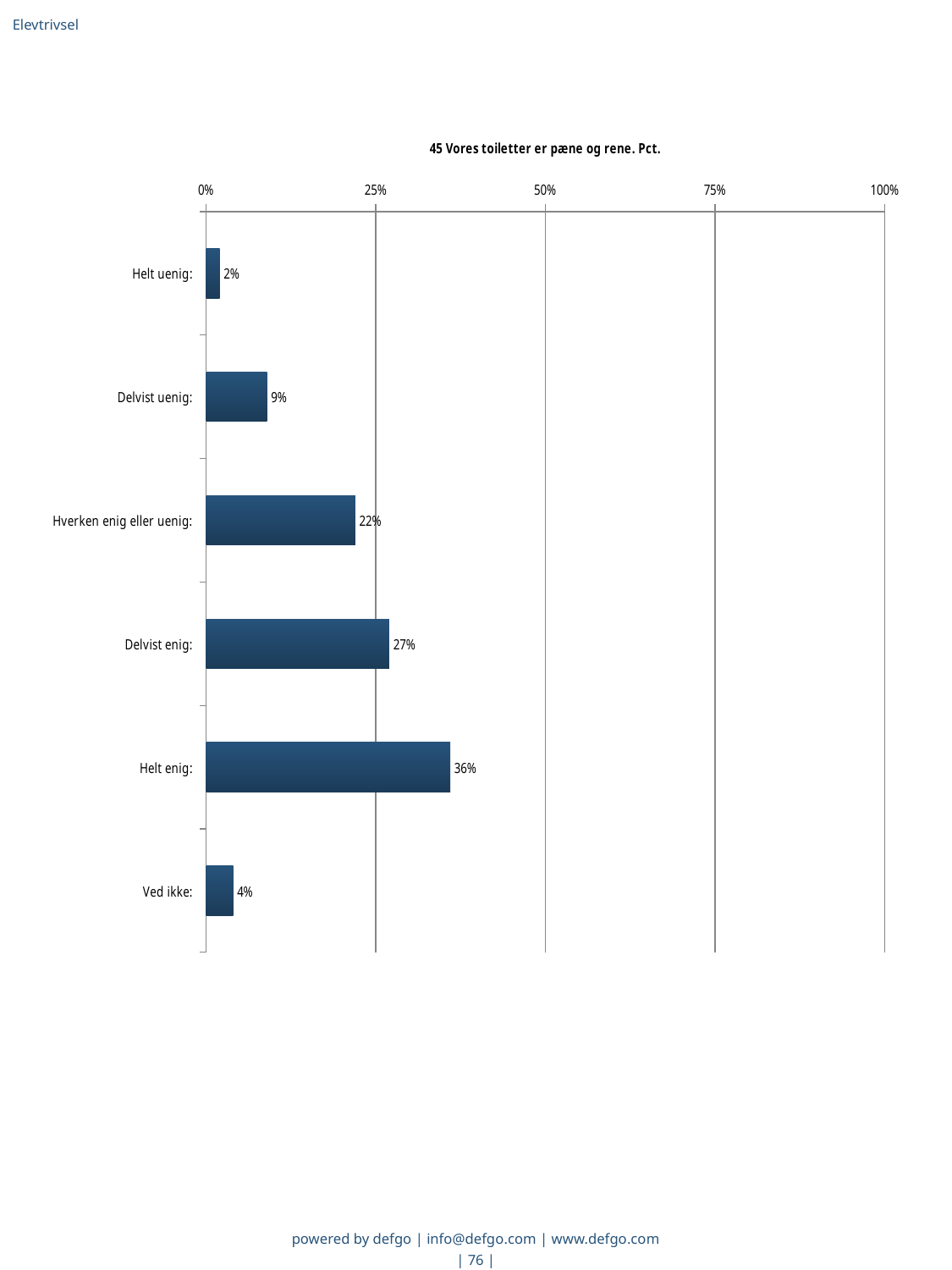
What is the value for "Helt enig"? 36% What is the value for "Ved ikke"? 4% Is the value for "Helt enig" greater or less than 25%? greater Which category has the lowest value? Helt uenig Which category has the highest value? Helt enig What is the difference between the values for "Helt enig" and "Delvist enig"? 9% What kind of chart is shown on the slide? bar chart What is the difference between the values for "Delvist uenig" and "Helt uenig"? 7% How many categories are shown in the chart? 6 What is the value for "Hverken enig eller uenig"? 22% What is the title of the chart? 45 Vores toiletter er pæne og rene. Pct. Which is larger, the value for "Delvist enig" or the value for "Hverken enig eller uenig"? Delvist enig